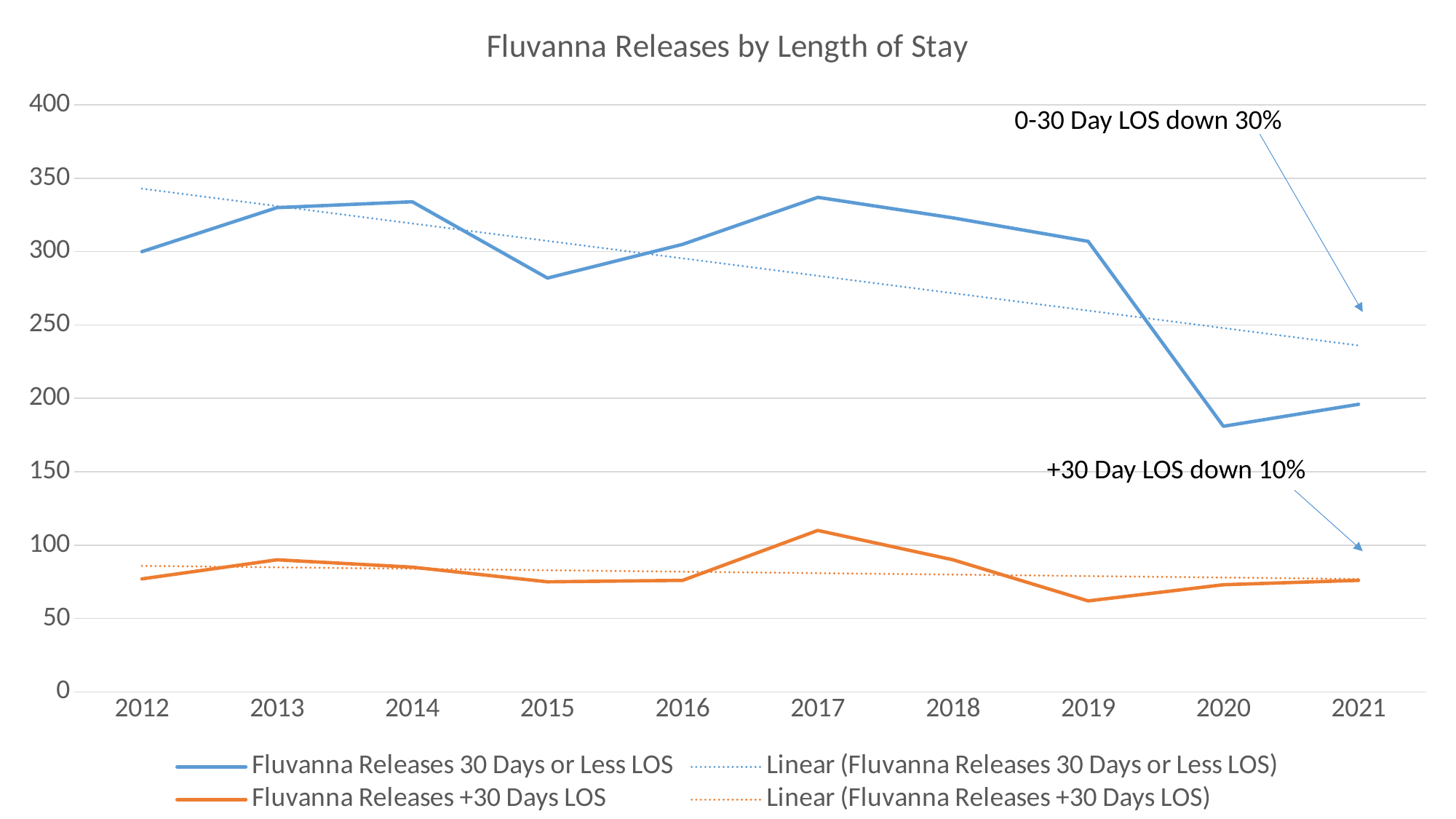
Is the value for Fluvanna Releases 30 Days or Less LOS in 2020 greater or less than 200? less Which series has the larger value in 2019, Fluvanna Releases 30 Days or Less LOS or Fluvanna Releases +30 Days LOS? Fluvanna Releases 30 Days or Less LOS How many entries does the legend list? 4 According to the annotation on the chart, by what percentage is 0-30 Day LOS down? 30% In which year is the Fluvanna Releases 30 Days or Less LOS series lowest? 2020 What is the title of the chart? Fluvanna Releases by Length of Stay In which year is the Fluvanna Releases +30 Days LOS series highest? 2017 What kind of chart is shown on the slide? line chart Is the value for Fluvanna Releases 30 Days or Less LOS in 2017 greater or less than 300? greater Is the value for Fluvanna Releases +30 Days LOS in 2017 greater or less than 100? greater How many years are shown on the x axis? 10 In which year is the Fluvanna Releases +30 Days LOS series lowest? 2019